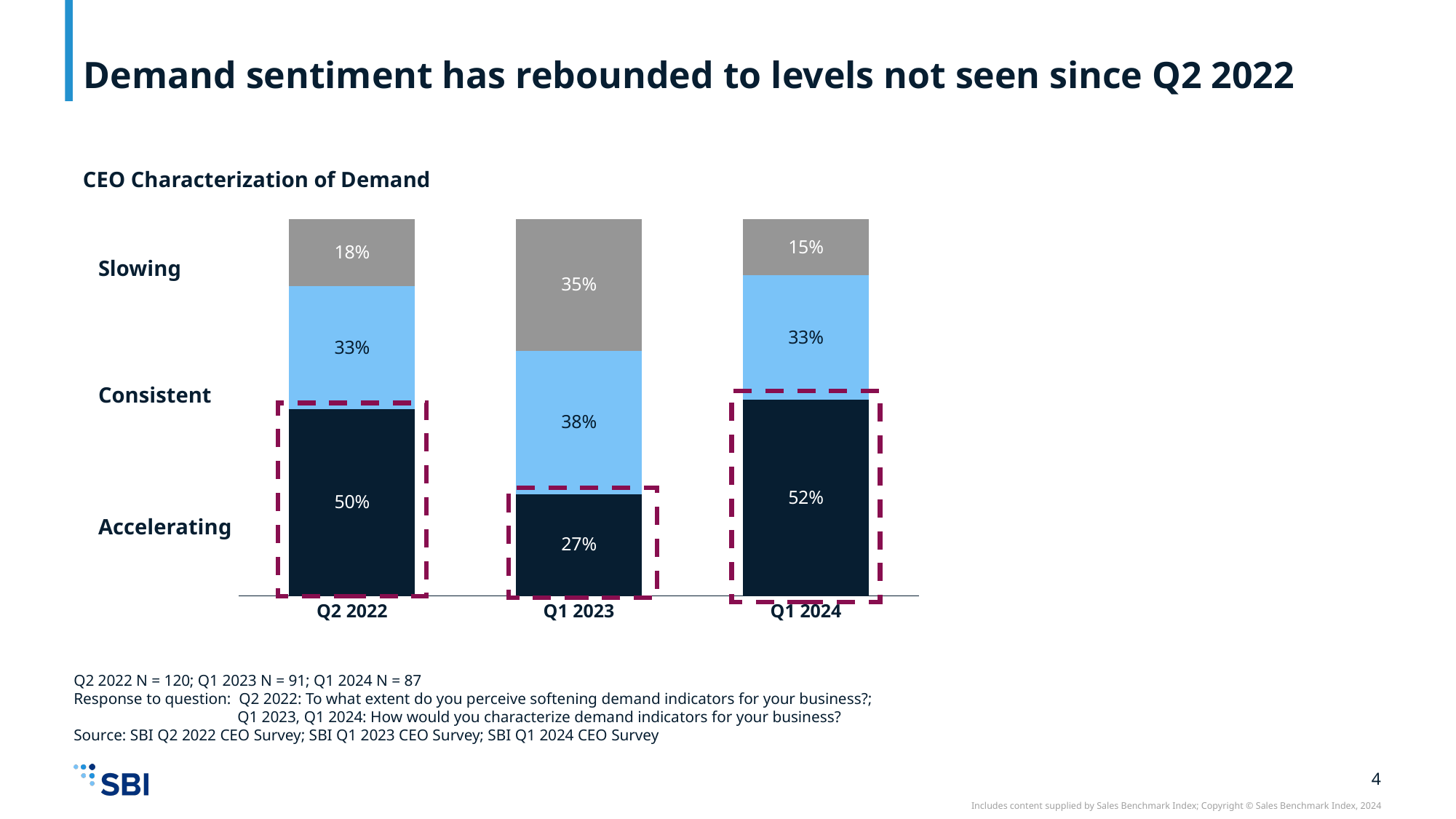
What percentage of CEOs characterized demand as Accelerating in Q1 2024? 52% What type of chart is shown? Stacked bar chart What is the title of the chart? CEO Characterization of Demand How many periods are shown on the x axis? 3 Which period has the lowest Slowing share? Q1 2024 Which period has the highest Accelerating share? Q1 2024 Is the Consistent share larger in Q1 2023 or in Q1 2024? Q1 2023 What is the Consistent value for Q2 2022? 33% What percentage of CEOs characterized demand as Slowing in Q1 2023? 35% What is the difference between the Accelerating share in Q1 2024 and in Q1 2023? 25 percentage points How many demand categories are stacked in each bar? 3 What is the Accelerating value for Q1 2023? 27%